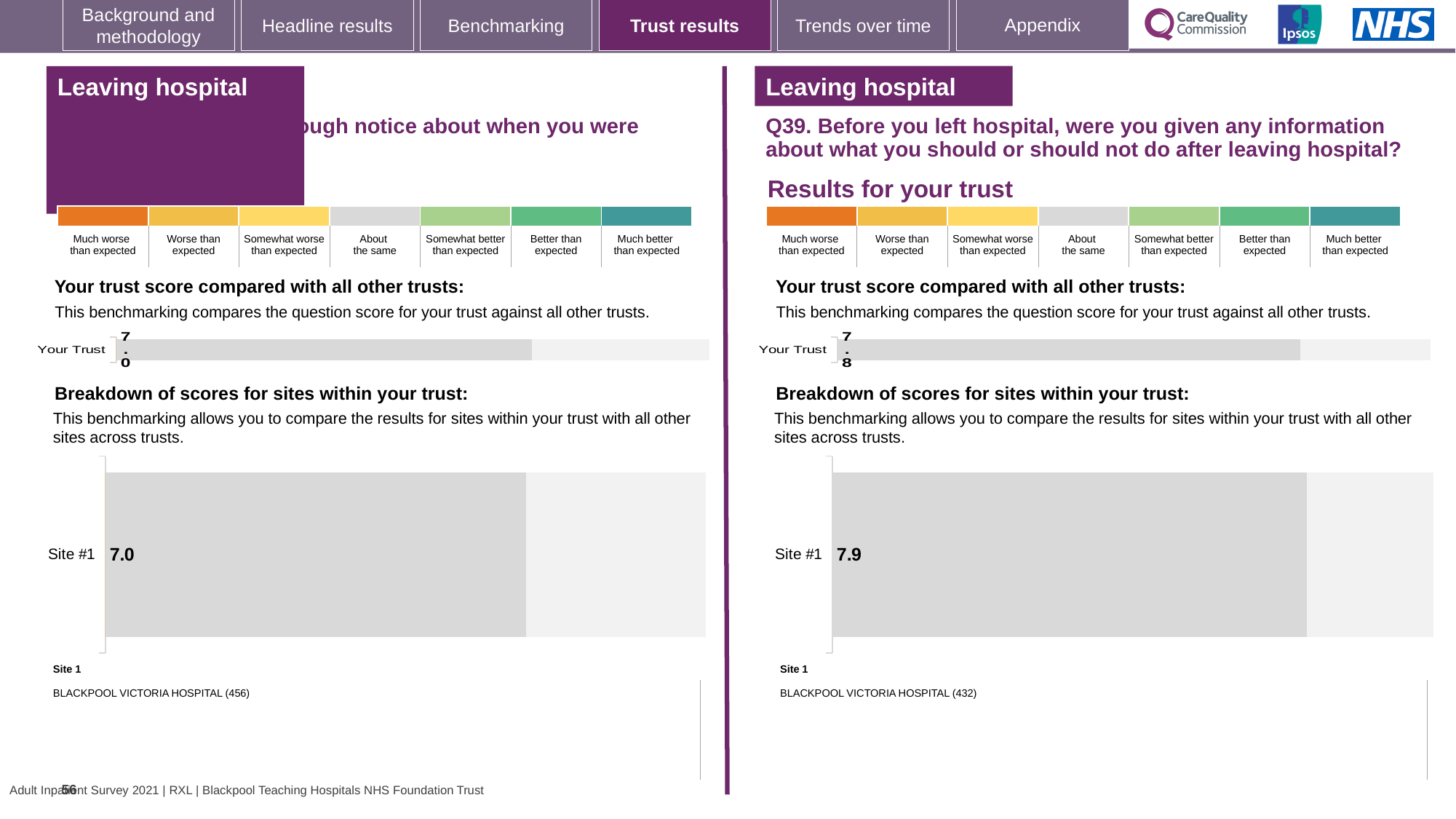
How many sites are shown in the 'Breakdown of scores for sites within your trust' chart on the left panel? 1 On the right panel (Q39), what is the difference between the Site #1 score and the Your Trust score? 0.1 On the right panel (Q39), what is the score shown for Site #1 in the 'Breakdown of scores for sites within your trust' chart? 7.9 Which site is listed as Site 1 on the right panel (Q39)? BLACKPOOL VICTORIA HOSPITAL (432) On the right panel (Q39), what is the score shown for Your Trust in the 'Your trust score compared with all other trusts' chart? 7.8 On the left panel, what is the score shown for Your Trust in the 'Your trust score compared with all other trusts' chart? 7.0 Which is larger: the Your Trust score on the left panel or the Your Trust score on the right panel (Q39)? Right panel (Q39) How many categories does the colour scale above the charts on the right panel (Q39) show? 7 What type of chart is used to show the Site #1 score on the right panel (Q39)? Bar chart On the left panel, what is the score shown for Site #1 in the 'Breakdown of scores for sites within your trust' chart? 7.0 What is the difference between the Site #1 score on the right panel (Q39) and the Site #1 score on the left panel? 0.9